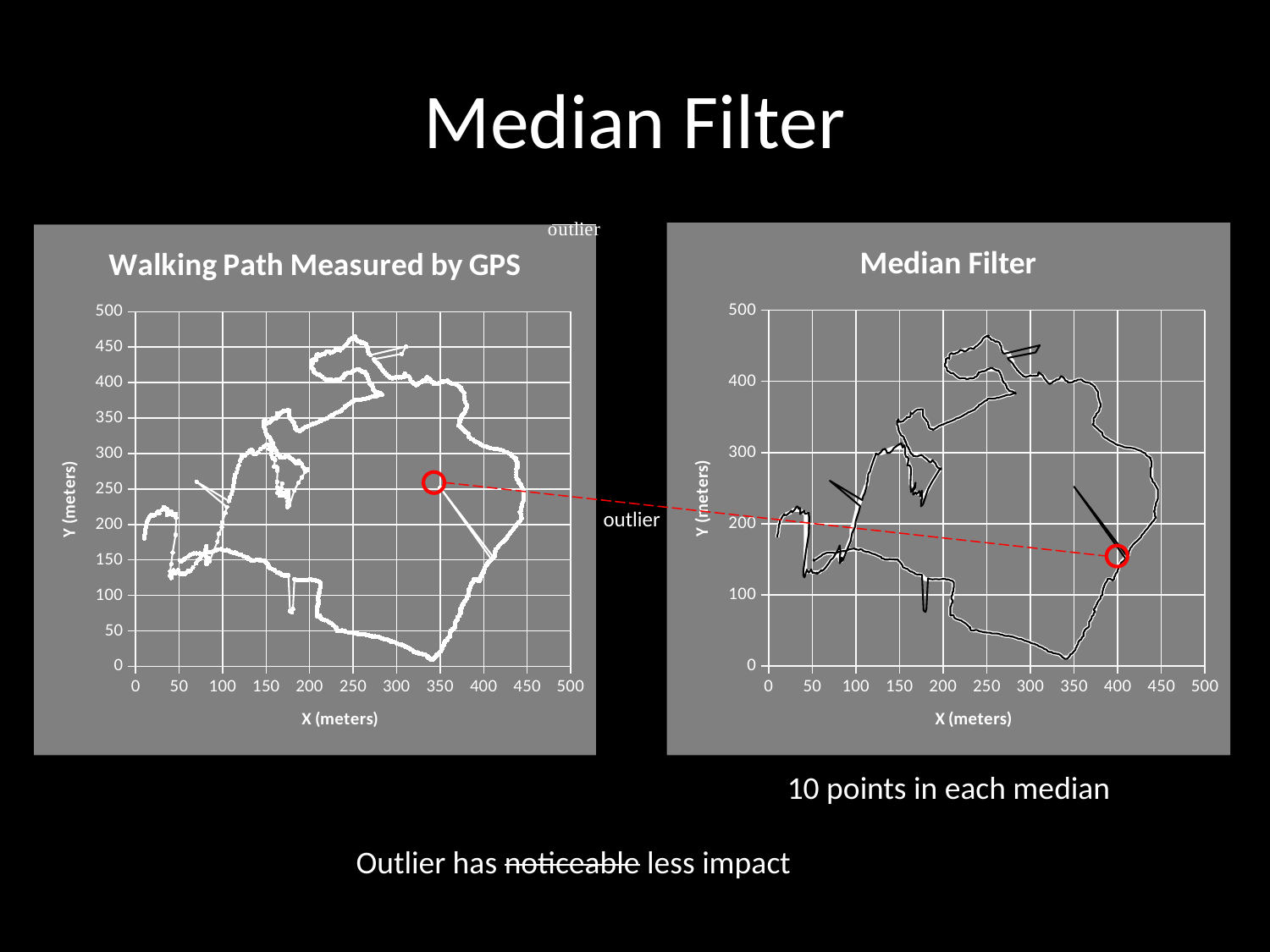
On the right chart, is the x value of the circled outlier greater or less than 350? greater On the left chart, is the x value of the circled outlier greater or less than 300? greater On the left chart, what is the spacing between consecutive y-axis tick labels? 50 What is the label of the x axis on the left chart? X (meters) On the right chart, what is the highest value shown on the x axis? 500 On the right chart, is the y value of the circled outlier greater or less than 200? less What is the title of the right chart? Median Filter Which chart has the circled outlier at a higher y value, the left chart or the right chart? the left chart On the right chart, what is the spacing between consecutive y-axis tick labels? 100 What kind of chart is the left chart titled "Walking Path Measured by GPS"? scatter (line) chart On the left chart, what is the highest value shown on the y axis? 500